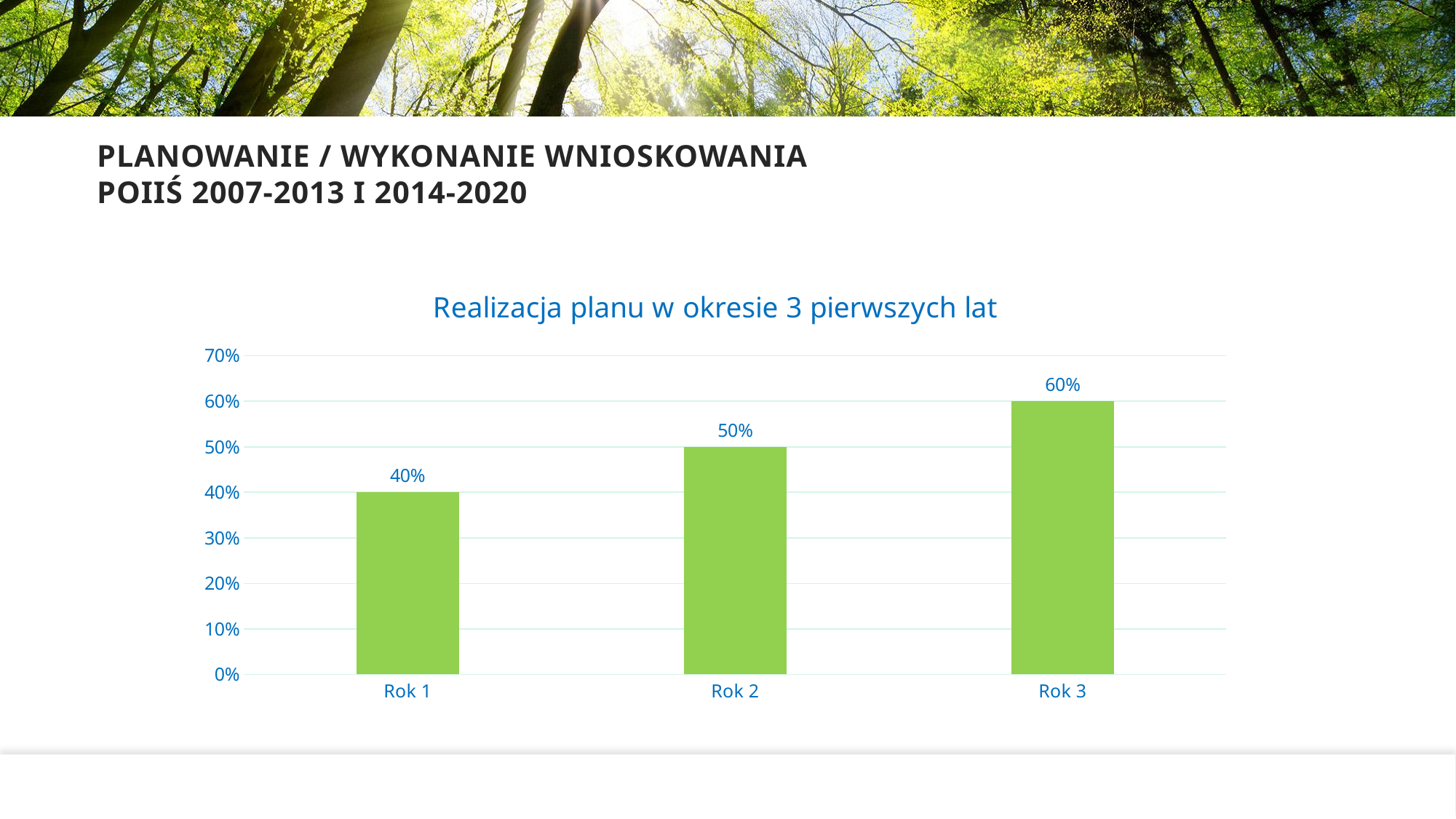
Is the value for Rok 1 greater or less than 50%? less Which is larger, the value for Rok 2 or the value for Rok 3? Rok 3 What is the value for Rok 3? 60% What kind of chart is shown on the slide? bar chart What is the difference between the values for Rok 3 and Rok 1? 20% Do the values rise or fall from Rok 1 to Rok 3? rise What is the value for Rok 1? 40% How many categories are shown on the x axis? 3 Which category has the lowest value? Rok 1 What is the value for Rok 2? 50% What is the difference between the values for Rok 2 and Rok 1? 10% Which category has the highest value? Rok 3